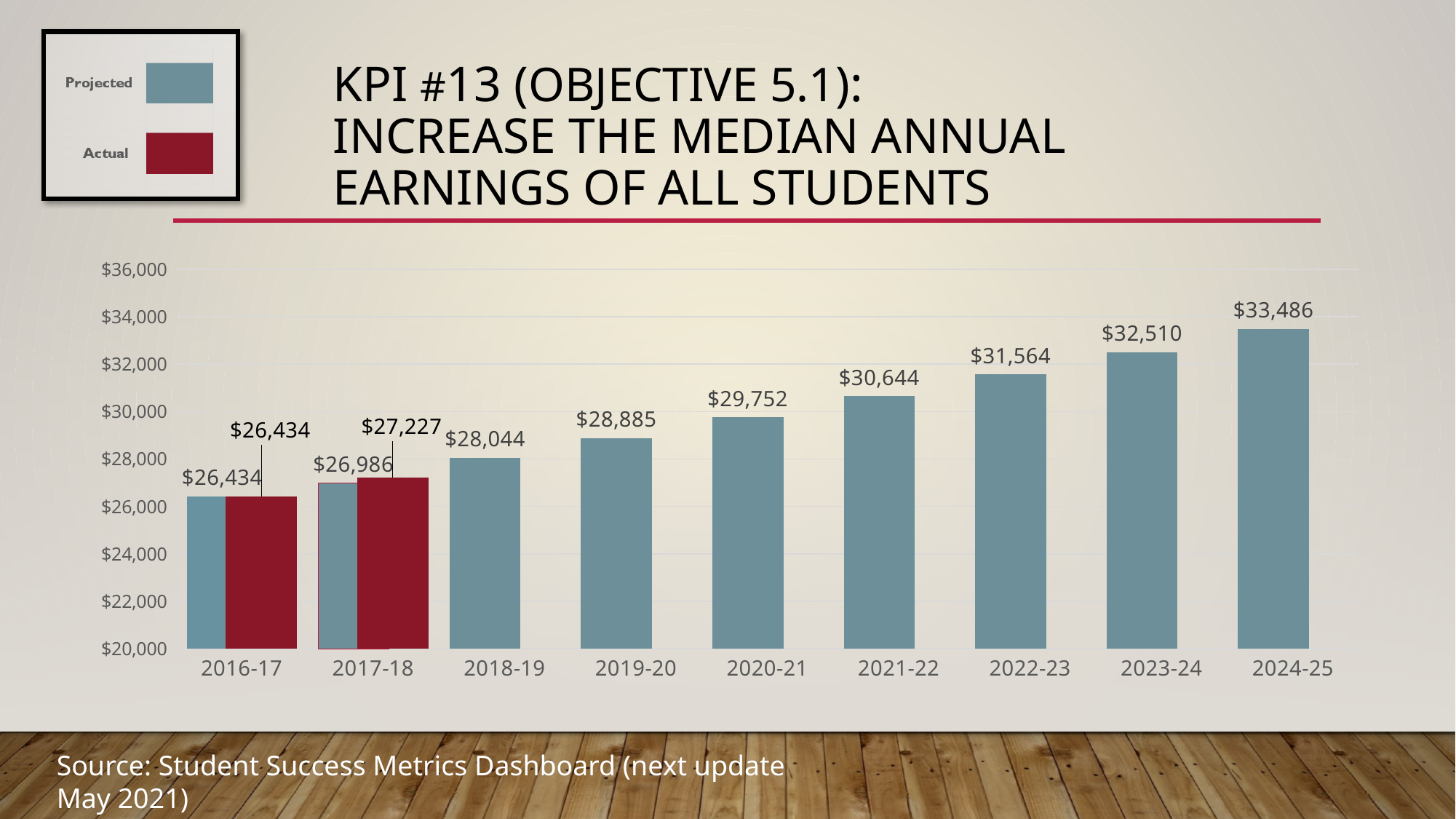
What is the difference between the projected median annual earnings for 2024-25 and 2016-17? $7,052 For 2017-18, which is larger: the projected or the actual median annual earnings? Actual What is the actual median annual earnings for 2017-18? $27,227 Which year has the highest projected median annual earnings? 2024-25 What is the difference between the actual and projected median annual earnings for 2017-18? $241 How many academic years are shown on the x axis? 9 Which year has the lowest projected median annual earnings? 2016-17 What is the projected median annual earnings for 2020-21? $29,752 What is the projected median annual earnings for 2024-25? $33,486 How many series does the legend list? 2 Do the projected median annual earnings rise or fall from 2016-17 to 2024-25? Rise What kind of chart is shown on the slide? Bar chart